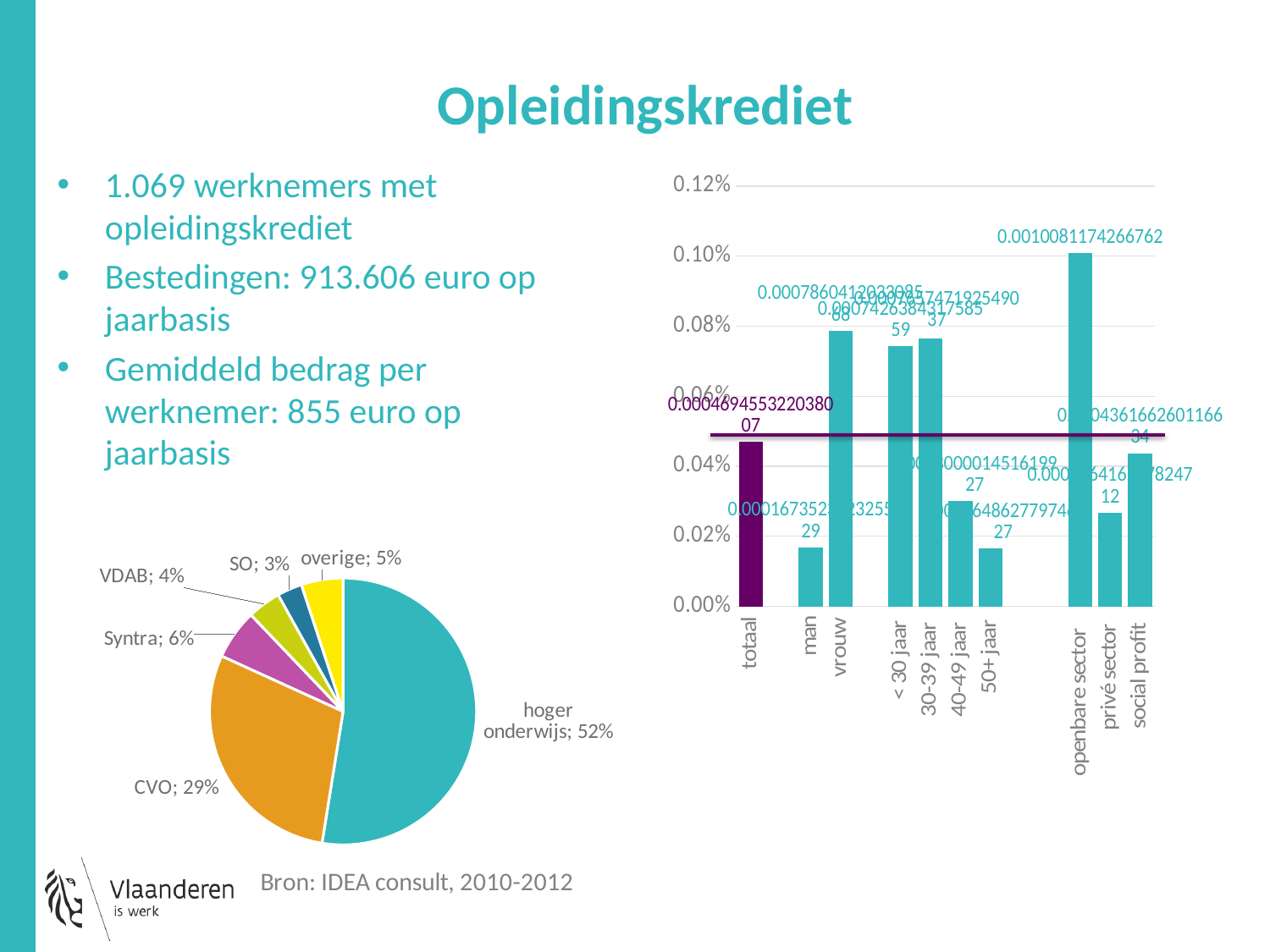
In the pie chart at the bottom left, which is larger: Syntra or VDAB? Syntra In the pie chart at the bottom left, what is the value for CVO? 29% In the bar chart on the right, how many categories are shown on the x axis? 10 In the bar chart on the right, is the value for 'totaal' greater or less than 0.06%? less What kind of chart is the chart on the right side of the slide? bar chart In the pie chart at the bottom left, how many percentage points larger is 'hoger onderwijs' than CVO? 23 In the pie chart at the bottom left, which category has the smallest share? SO In the bar chart on the right, which category has the highest bar? openbare sector In the pie chart at the bottom left, what share does 'hoger onderwijs' have? 52% In the pie chart at the bottom left, which category has the largest share? hoger onderwijs In the bar chart on the right, is the value for 'man' greater or less than 0.02%? less In the pie chart at the bottom left, how many slices are there? 6